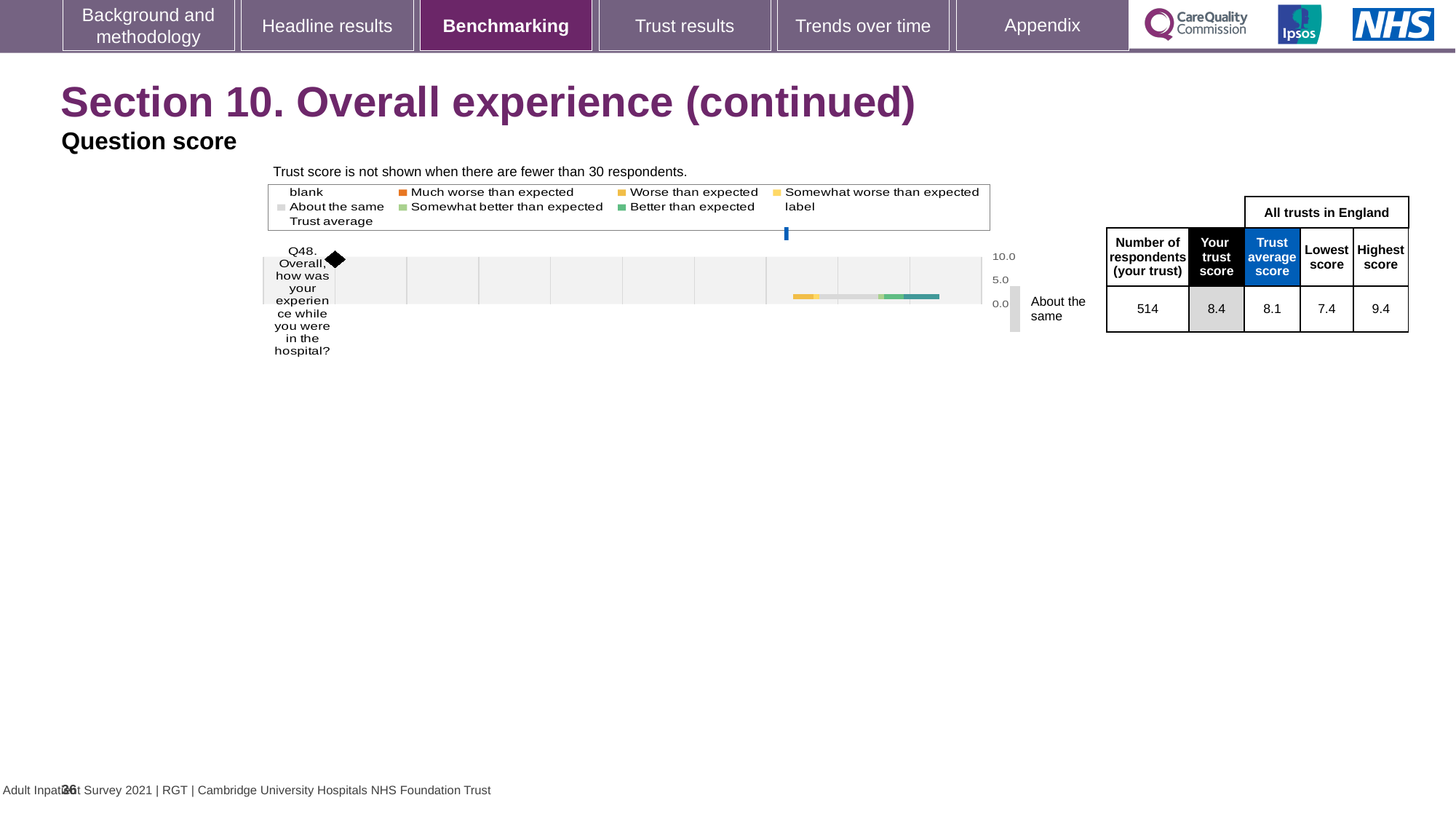
What type of chart is used to show the benchmarking for Q48? bar chart What is the highest value shown on the chart's axis? 10.0 What is the trust average score for Q48 across all trusts in England? 8.1 What is the difference between the highest score and the lowest score for Q48 across all trusts in England? 2.0 How many questions (categories) are plotted on the chart? 1 What is the trust score for Q48 shown in the table next to the chart? 8.4 Which is larger for Q48, the trust score or the trust average score? trust score What is the lowest score among all trusts in England for Q48? 7.4 What benchmarking category is the trust's Q48 score placed in, according to the label beside the chart? About the same Which question is plotted on the chart? Q48. Overall, how was your experience while you were in the hospital? How many respondents from the trust answered Q48? 514 What is the highest score among all trusts in England for Q48? 9.4